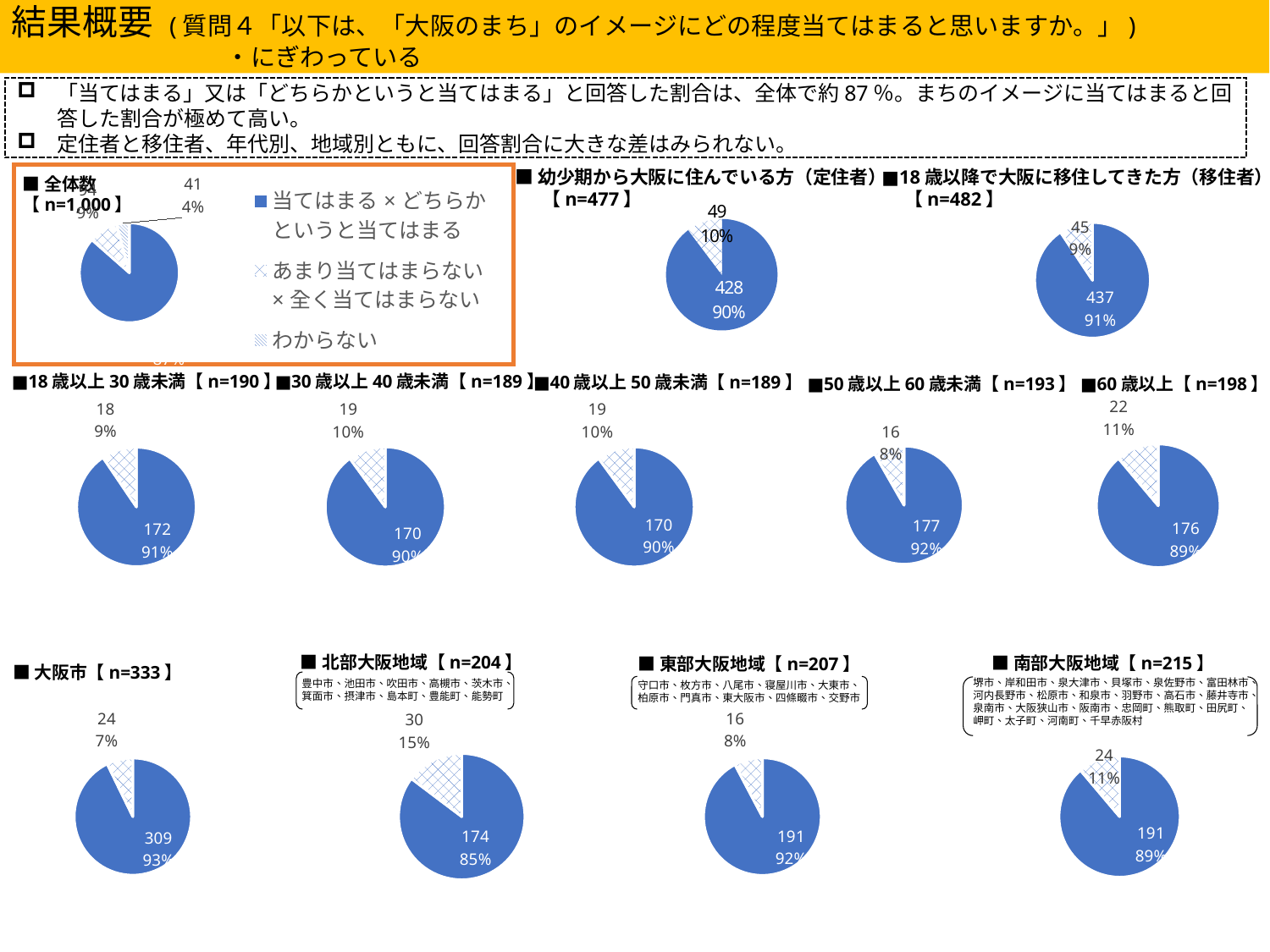
Which has the larger count for 当てはまる × どちらかというと当てはまる: the 定住者【n=477】 chart or the 移住者【n=482】 chart? 移住者【n=482】 In the 60歳以上【n=198】 pie chart, what percentage is shown for the 当てはまる × どちらかというと当てはまる slice? 89% In the 大阪市【n=333】 pie chart, what is the count for 当てはまる × どちらかというと当てはまる? 309 How many entries does the legend next to the 全体数【n=1,000】 chart list? 3 What kind of chart is used throughout this slide? Pie chart In the 南部大阪地域【n=215】 pie chart, what is the count for あまり当てはまらない × 全く当てはまらない? 24 In the 北部大阪地域【n=204】 pie chart, what percentage is shown for the あまり当てはまらない × 全く当てはまらない slice? 15% In the 50歳以上60歳未満【n=193】 pie chart, what is the count for あまり当てはまらない × 全く当てはまらない? 16 In the 全体数【n=1,000】 pie chart, what percentage is shown for the わからない slice labelled 41? 4% What is the difference between the 当てはまる × どちらかというと当てはまる counts in the 東部大阪地域【n=207】 chart and the 北部大阪地域【n=204】 chart? 17 In the 幼少期から大阪に住んでいる方（定住者）【n=477】 pie chart, what is the count for 当てはまる × どちらかというと当てはまる? 428